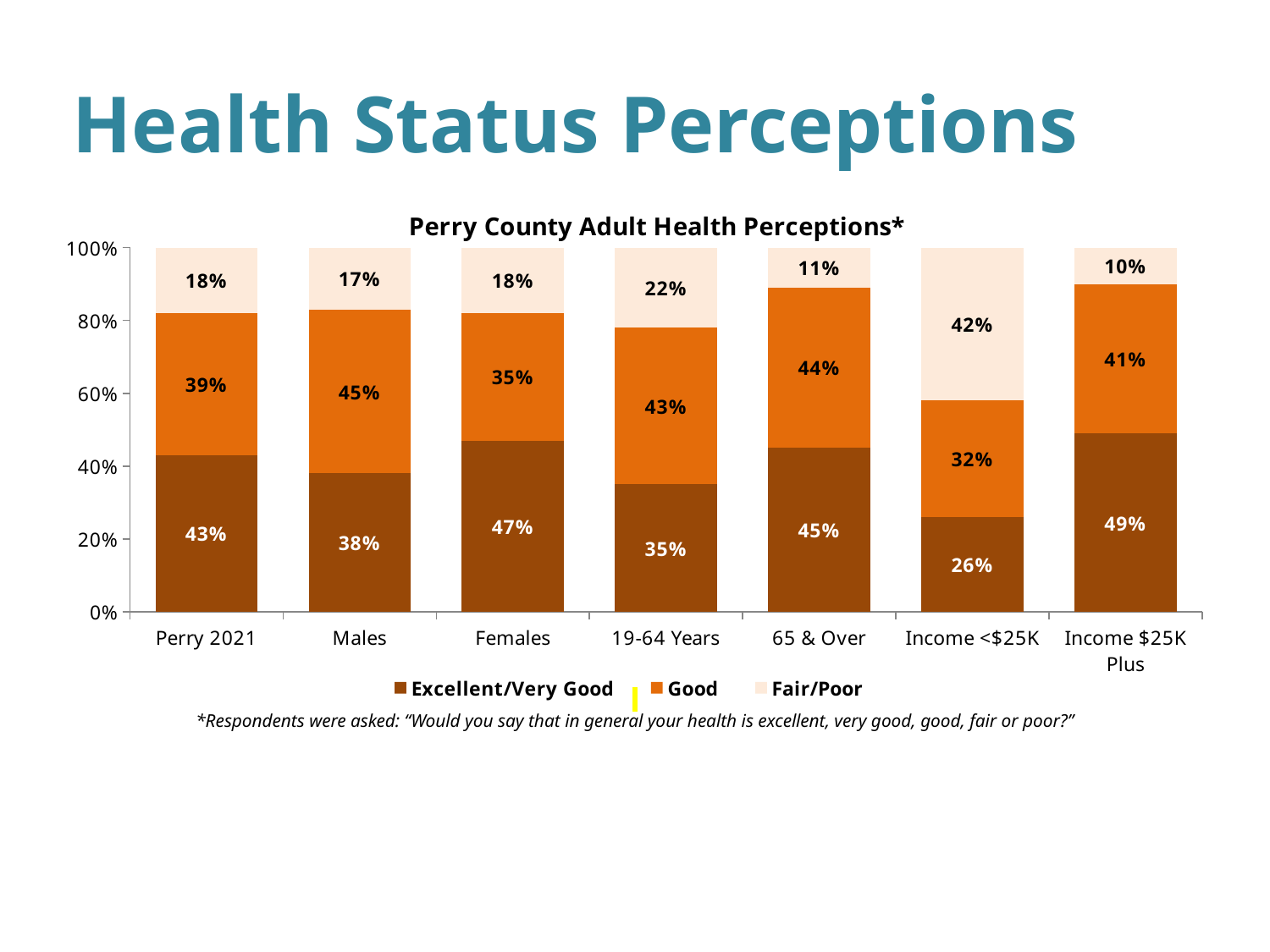
What percentage of Males rated their health as Excellent/Very Good? 38% What is the Fair/Poor value for Income <$25K? 42% How many series does the legend list? 3 What kind of chart is shown? Stacked bar chart What is the total of the Excellent/Very Good and Good segments for Perry 2021? 82% What is the difference between the Excellent/Very Good values for Females and Males? 9% Which category has the lowest Fair/Poor value? Income $25K Plus How many categories are shown on the x axis? 7 Which category has the highest Excellent/Very Good value? Income $25K Plus Which is larger, the Good value for Males or the Good value for Females? Males What is the title of the chart? Perry County Adult Health Perceptions* What is the Good value for 65 & Over? 44%